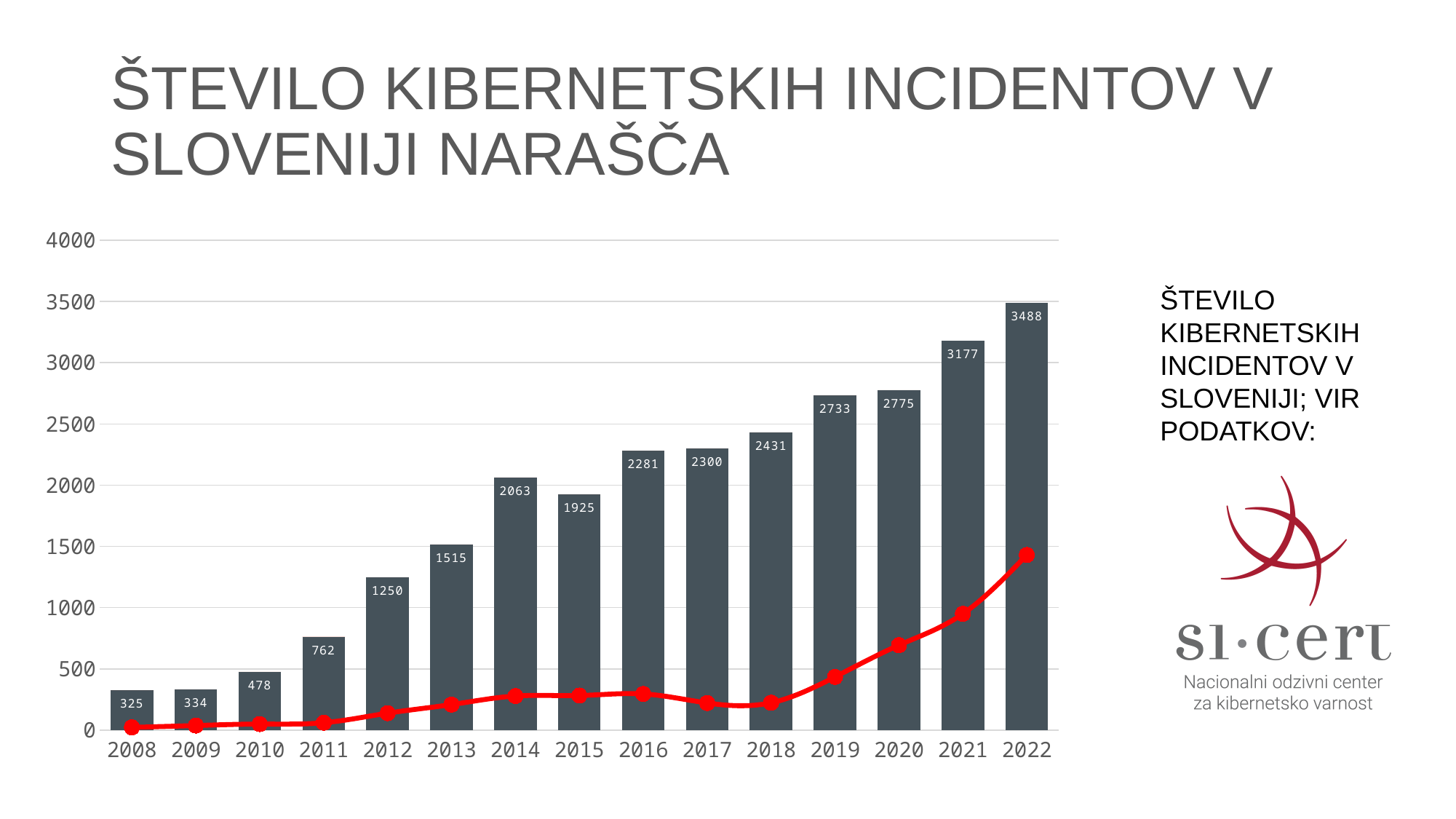
What is the difference between the bar values for 2022 and 2021? 311 Which year has the highest bar? 2022 Which year has the lowest bar? 2008 What kind of chart is shown on the slide? combination bar and line chart What is the difference between the bar values for 2014 and 2015? 138 Which bar is larger, 2014 or 2015? 2014 What is the value of the bar for 2012? 1250 What is the value of the bar for 2022? 3488 How many years are shown on the x axis? 15 Is the value of the red line for 2020 greater or less than 500? greater What is the value of the bar for 2015? 1925 Do the bar values generally rise or fall from 2008 to 2022? rise